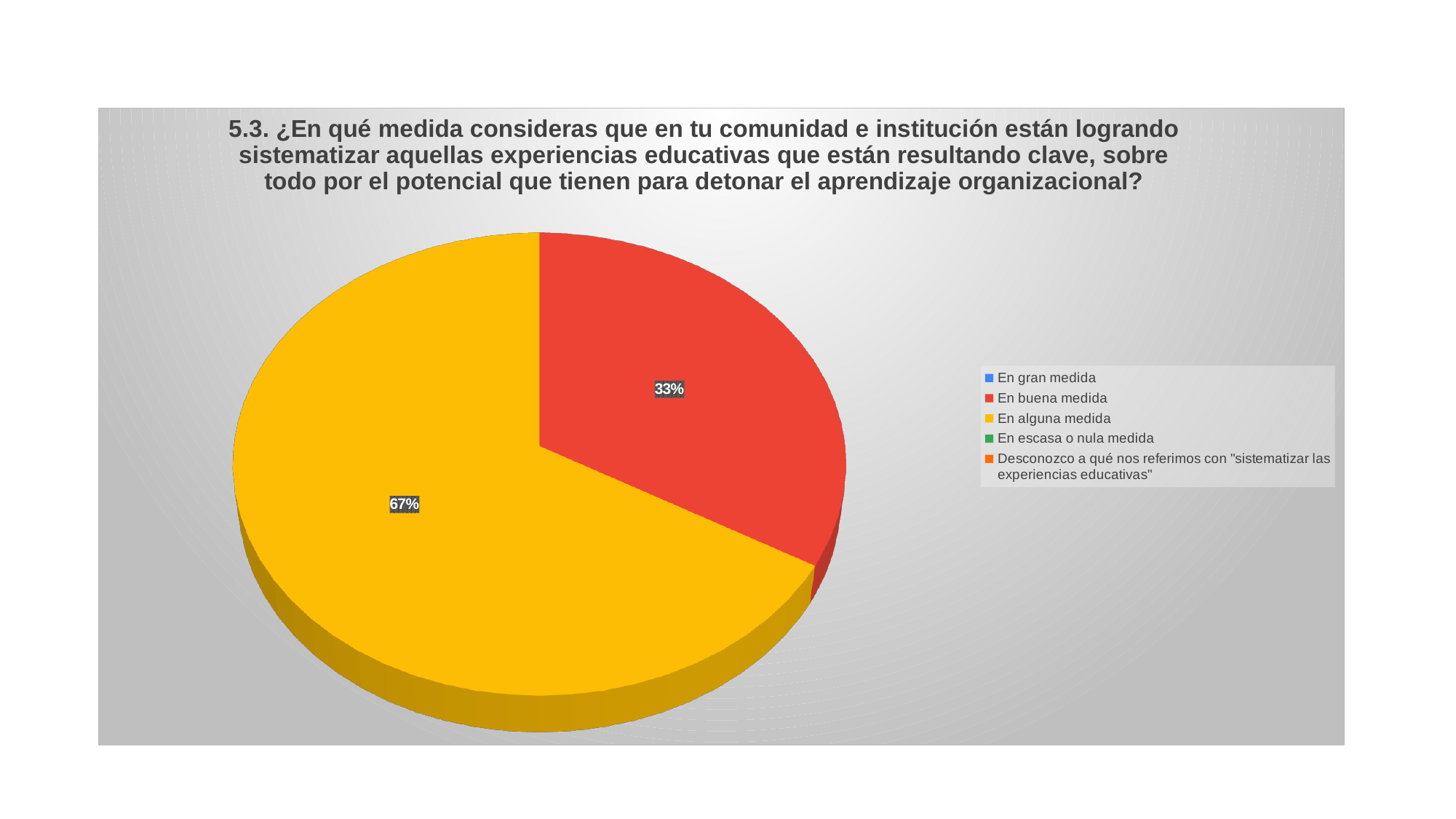
What percentage of the pie corresponds to "En buena medida"? 33% Which legend entry is shown in red? En buena medida What share of the pie does the yellow slice represent? 67% Which is larger, the share for "En buena medida" or the share for "En alguna medida"? En alguna medida How many entries does the legend list? 5 How many slices are visible in the pie chart? 2 What kind of chart is shown on the slide? pie chart Which of the two visible slices is smaller, "En buena medida" or "En alguna medida"? En buena medida What is the difference in percentage points between the "En alguna medida" slice and the "En buena medida" slice? 34% What percentage of the pie corresponds to "En alguna medida"? 67% Which category has the largest slice of the pie? En alguna medida What colour is the slice labelled 67%? yellow